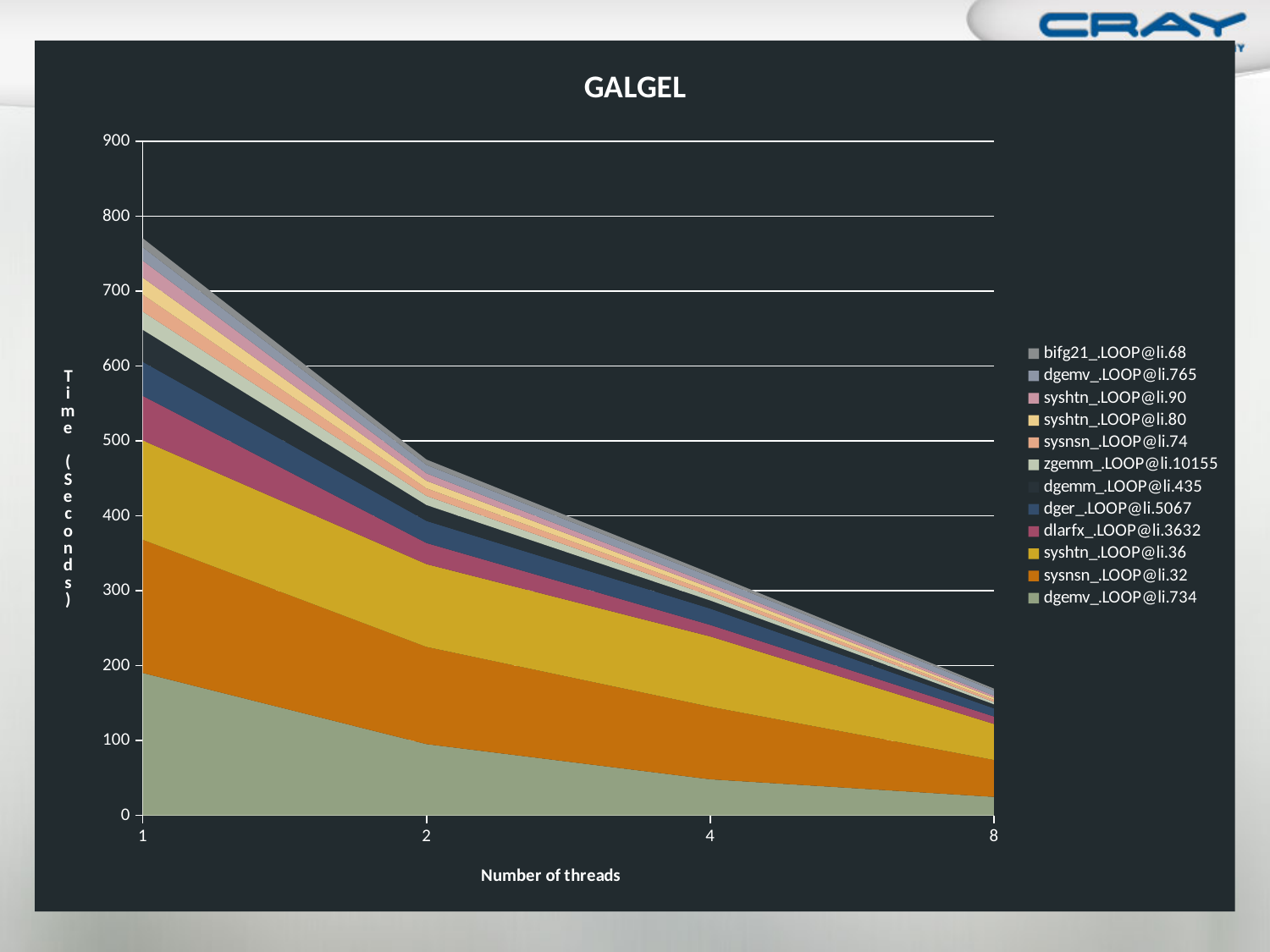
Is the value for dgemv_.LOOP@li.734 at 8 threads greater or less than 100? less How many series does the legend list? 12 What is the label of the x axis? Number of threads Is the total stacked time at 1 thread greater or less than 700? greater Which is larger, the total stacked time at 1 thread or at 4 threads? 1 thread How many thread counts are plotted along the x axis? 4 Is the total stacked time at 2 threads greater or less than 500? less What kind of chart is shown on the slide? stacked area chart What is the title of the chart? GALGEL Does the total time rise or fall as the number of threads increases? fall